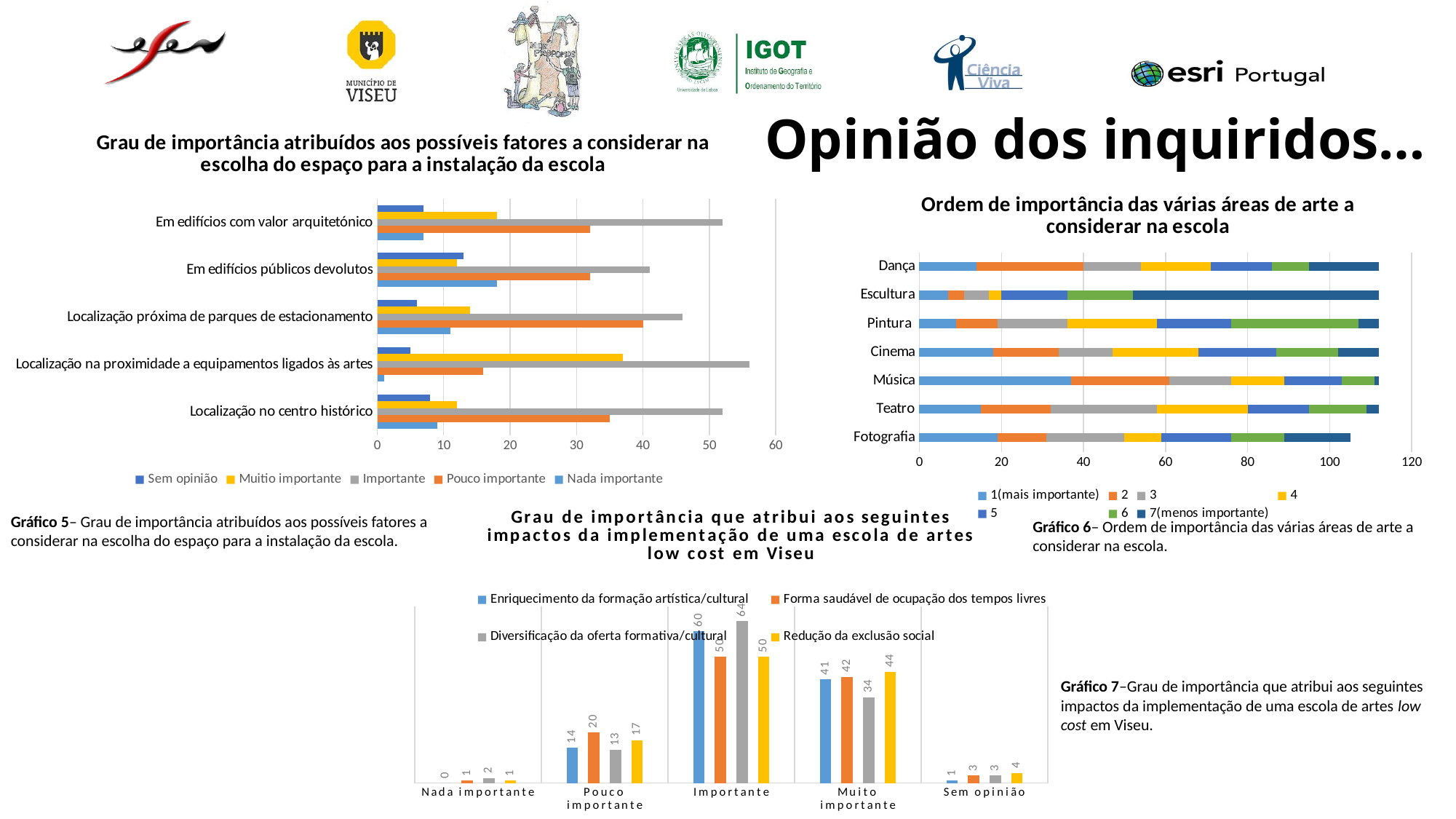
In Gráfico 7, which category has the highest value for 'Enriquecimento da formação artística/cultural'? Importante In Gráfico 5, is the 'Importante' value for 'Localização na proximidade a equipamentos ligados às artes' greater or less than 50? greater In Gráfico 7, in the 'Importante' category, what is the difference between 'Diversificação da oferta formativa/cultural' and 'Forma saudável de ocupação dos tempos livres'? 14 In Gráfico 5, which has the larger 'Importante' value: 'Em edifícios com valor arquitetónico' or 'Localização próxima de parques de estacionamento'? Em edifícios com valor arquitetónico How many categories are shown on the x axis of Gráfico 7? 5 In Gráfico 7, what is the value for 'Forma saudável de ocupação dos tempos livres' in the 'Pouco importante' category? 20 How many art areas (categories) are shown in Gráfico 6 (Ordem de importância das várias áreas de arte)? 7 What kind of chart is Gráfico 5 (Grau de importância atribuídos aos possíveis fatores...)? Bar chart How many series does the legend of Gráfico 7 list? 4 In Gráfico 7 (Grau de importância que atribui aos seguintes impactos...), what is the value for 'Diversificação da oferta formativa/cultural' in the 'Importante' category? 64 In Gráfico 7, what is the value for 'Redução da exclusão social' in the 'Muito importante' category? 44 How many series does the legend of Gráfico 5 list? 5